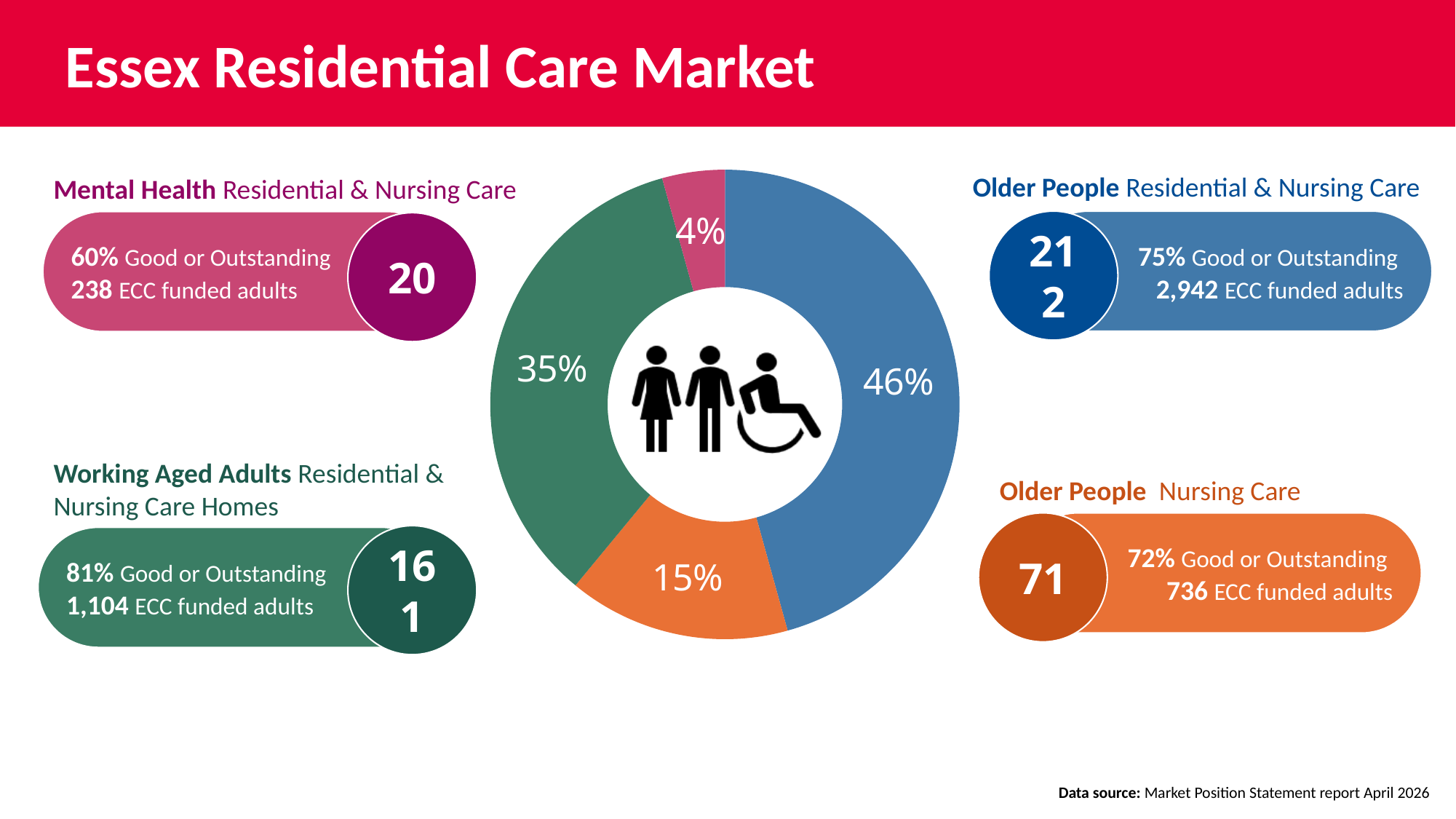
What kind of chart is shown in the centre of the slide? donut (pie) chart How many slices does the donut chart have? 4 What is the difference between the blue slice (46%) and the green slice (35%) in the donut chart? 11 percentage points What percentage is shown on the pink slice of the donut chart? 4% What is the title of the slide containing the donut chart? Essex Residential Care Market What percentage is shown on the blue slice of the donut chart? 46% Which slice of the donut chart is the smallest? the pink slice (4%) In the donut chart, which is larger: the green slice or the orange slice? the green slice (35%) What percentage is shown on the green slice of the donut chart? 35% Which slice of the donut chart is the largest? the blue slice (46%) What percentage is shown on the orange slice of the donut chart? 15% What is the difference between the green slice (35%) and the orange slice (15%) in the donut chart? 20 percentage points